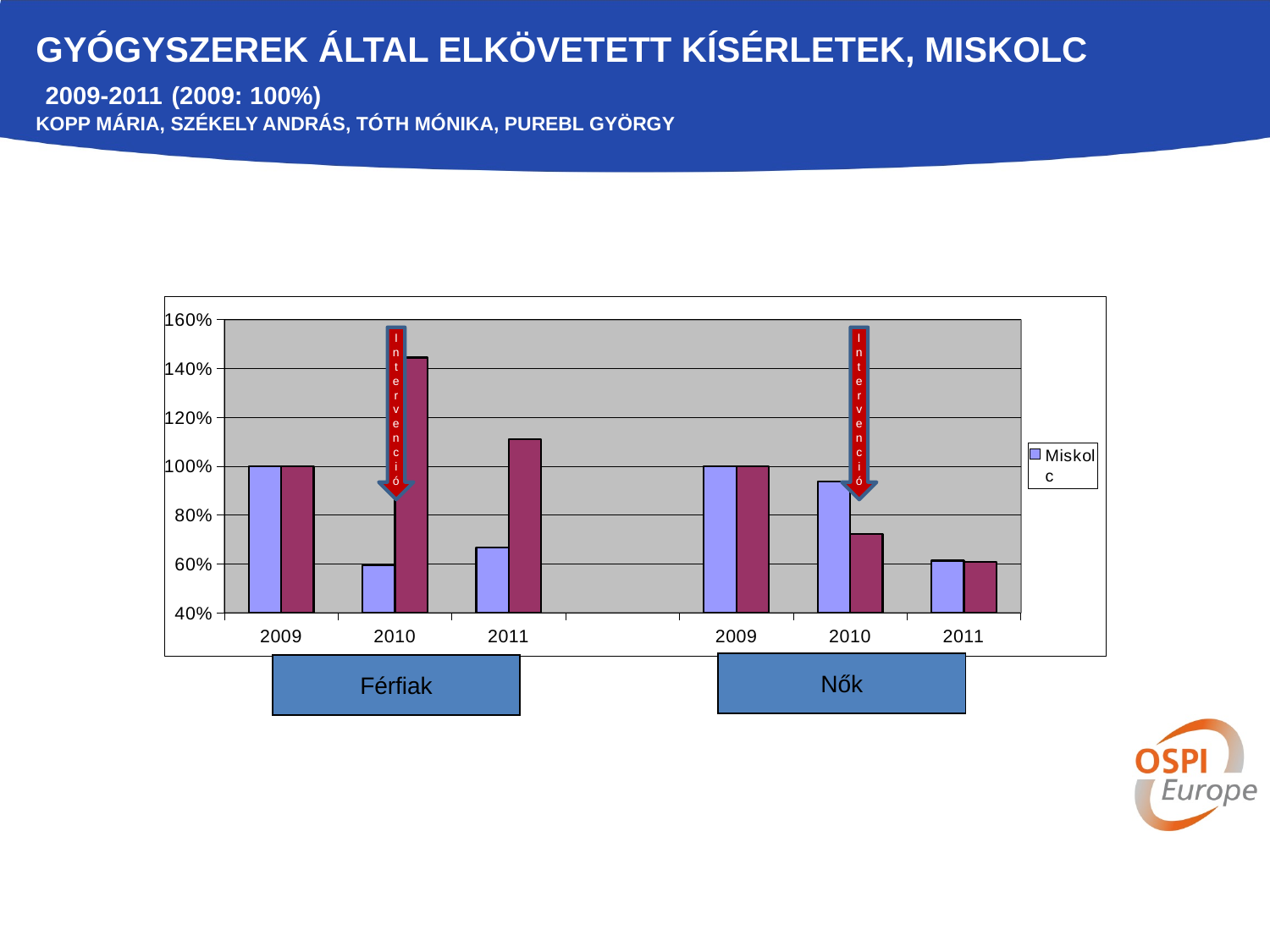
In which year is the Miskolc series lowest within the Férfiak group? 2010 Is the value of the dark red series for 2010 in the Nők group greater or less than 80%? less Does the Miskolc series rise or fall from 2009 to 2011 in the Nők group? fall Is the value of the dark red series for 2011 in the Férfiak group greater or less than 100%? greater Is the value of the Miskolc series for 2010 in the Férfiak group greater or less than 80%? less What is the value of the Miskolc series for 2009 in the Férfiak group? 100% In the Férfiak group for 2010, which series has the larger value, Miskolc or the dark red series? the dark red series In which year is the dark red series highest within the Férfiak group? 2010 In the Nők group for 2010, which series has the larger value, Miskolc or the dark red series? Miskolc What is the value of the dark red series for 2009 in the Nők group? 100% What kind of chart is shown on the slide? bar chart